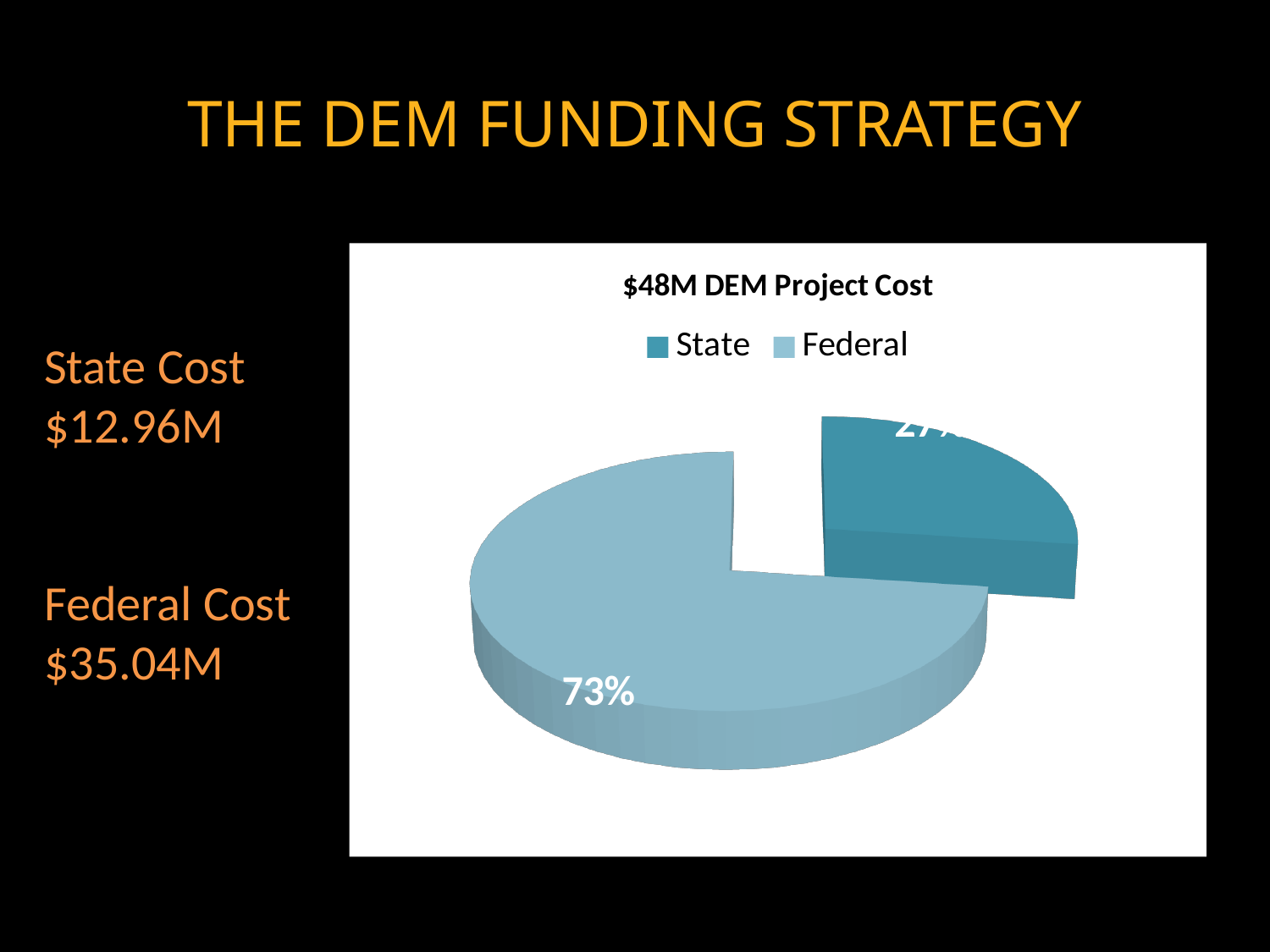
Which is larger, the State slice or the Federal slice? Federal What are the two categories listed in the chart legend? State and Federal What total project cost is stated in the chart title? $48M Which slice of the pie is the smallest? State What is the title of the chart? $48M DEM Project Cost Is the Federal share of the pie greater or less than 50%? greater What kind of chart is shown on the slide? Pie chart What share of the pie does the Federal slice represent? 73% Which slice of the pie is the largest? Federal How many series does the chart legend list? 2 How many slices does the pie chart have? 2